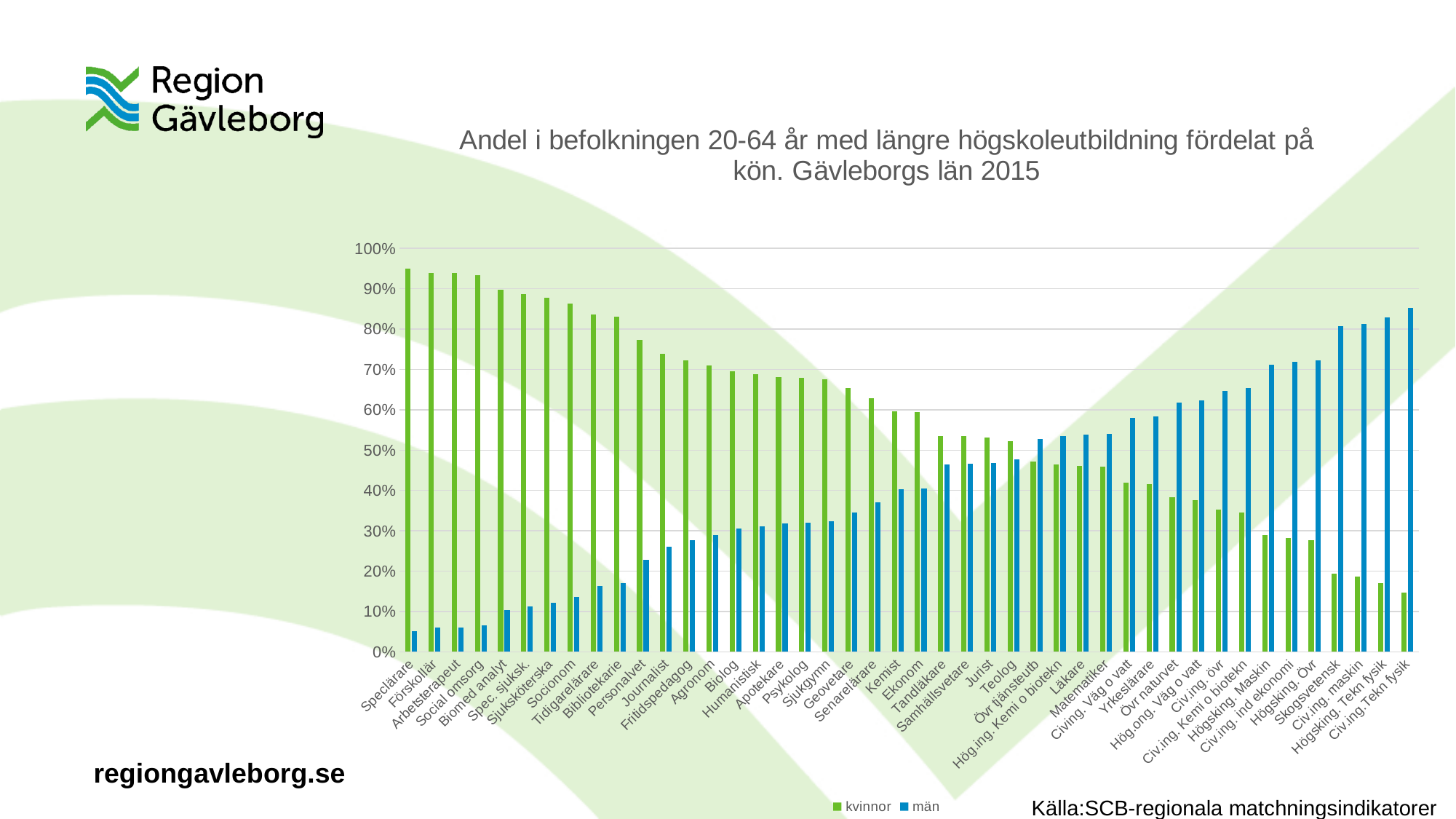
Which category has the highest value for kvinnor? Speclärare How many series does the legend list? 2 Is the value for kvinnor for Psykolog greater or less than 60%? greater Which category has the highest value for män? Civ.ing.Tekn fysik For Sjuksköterska, which series has the larger value, kvinnor or män? kvinnor Do the values for kvinnor generally rise or fall from left to right along the x axis? fall Is the value for kvinnor for Läkare greater or less than 50%? less Which category has the lowest value for män? Speclärare What kind of chart is shown on the slide? Bar chart How many education categories are shown on the x axis? 44 Which series are listed in the legend? kvinnor and män Is the value for män for Journalist greater or less than 20%? greater